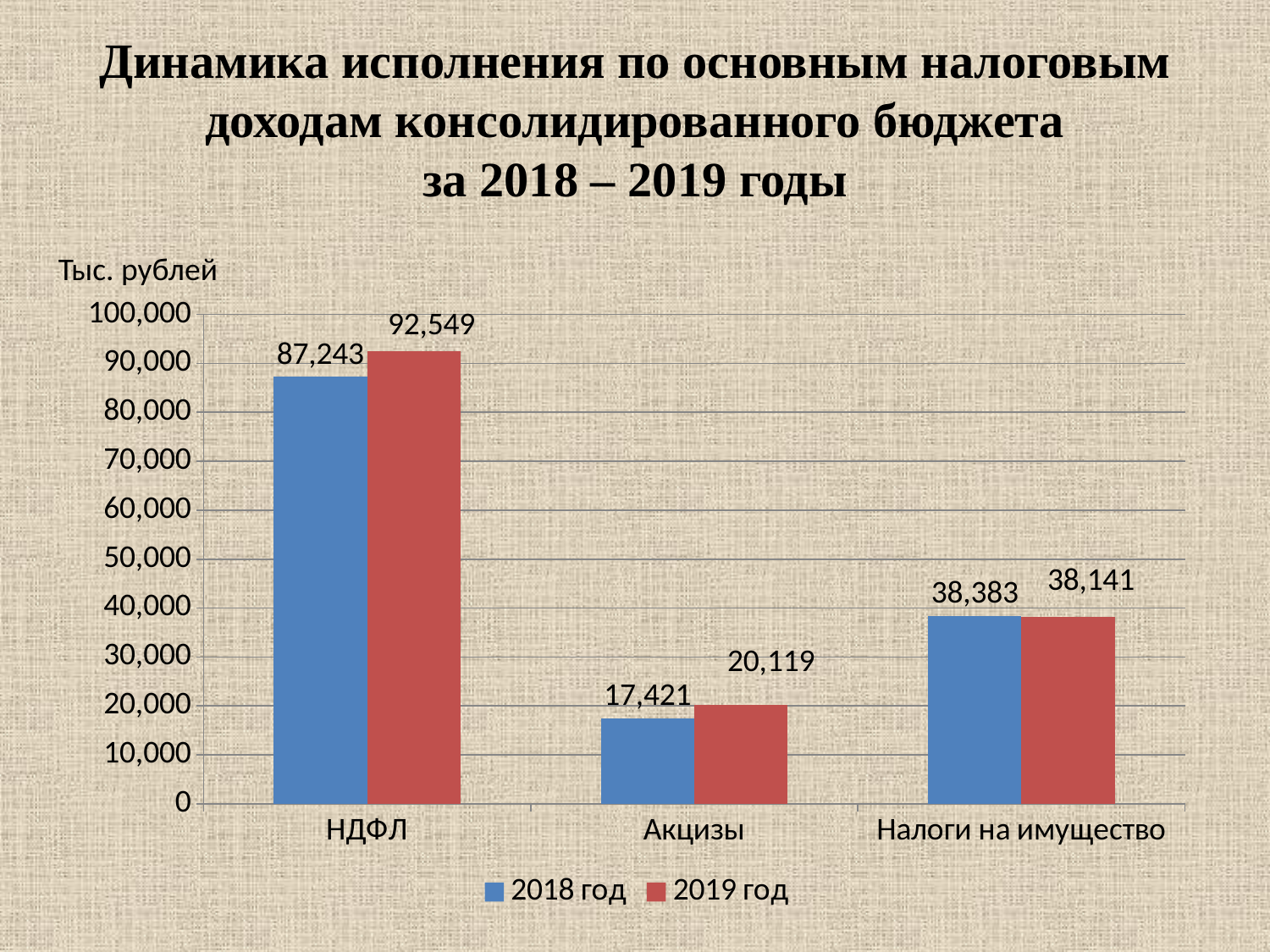
How many series does the legend list? 2 What is the value for Налоги на имущество in 2018 год? 38,383 Which category has the highest value in 2019 год? НДФЛ Which is larger for Акцизы: the 2018 год value or the 2019 год value? 2019 год What type of chart is shown on the slide? bar chart What is the value for НДФЛ in 2018 год? 87,243 What is the difference between the 2019 год and 2018 год values for НДФЛ? 5,306 What is the difference between the 2018 год and 2019 год values for Налоги на имущество? 242 What is the value for Акцизы in 2019 год? 20,119 How many categories are shown on the x axis? 3 Which category has the lowest value in 2018 год? Акцизы What is the value for НДФЛ in 2019 год? 92,549